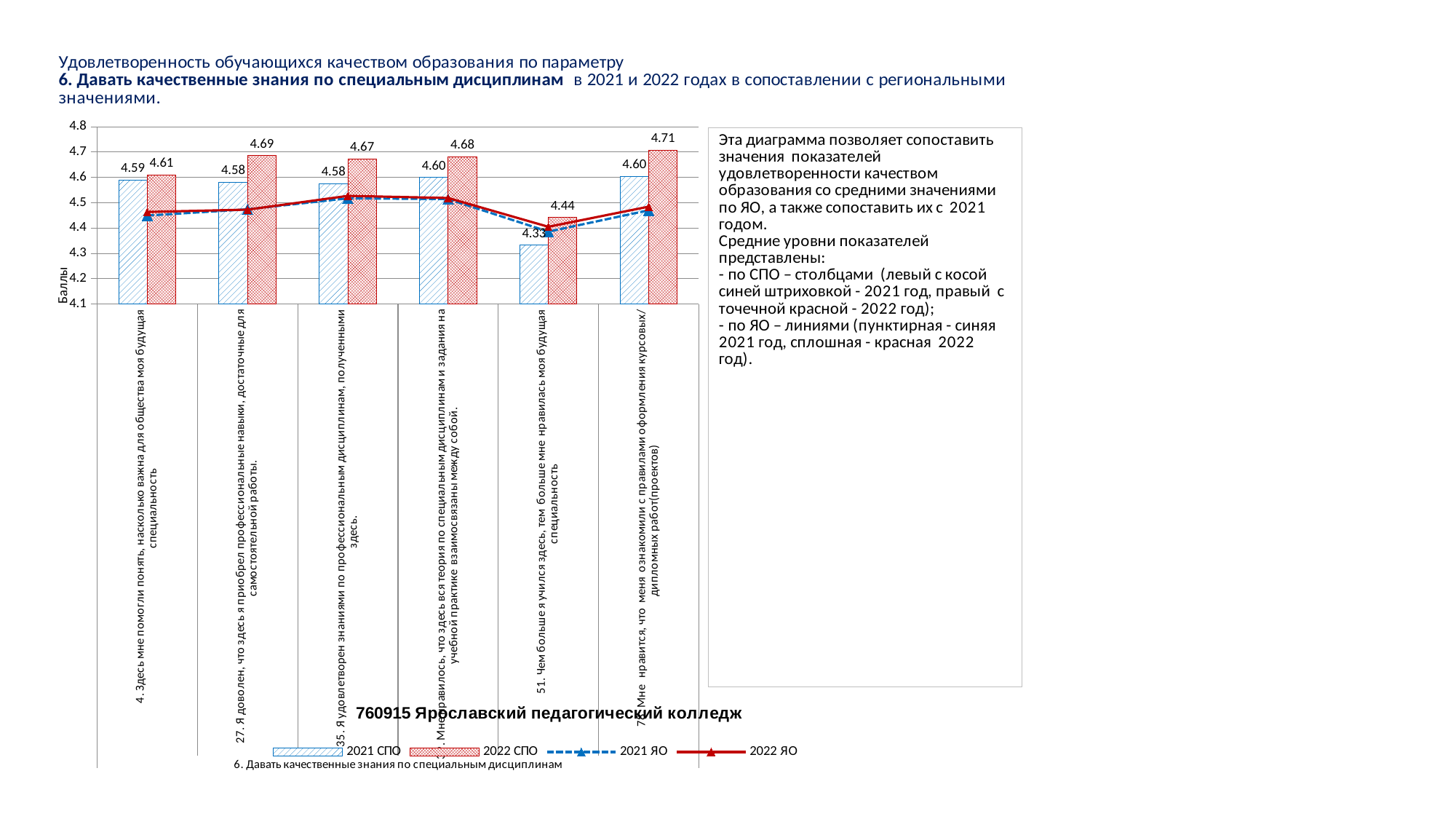
Which category has the lowest 2021 СПО value? 51. Чем больше я учился здесь, тем больше мне нравилась моя будущая специальность How many categories are shown on the x axis? 6 How many series does the legend list? 4 What kind of chart is shown on the slide? Combined bar and line chart What is the 2021 СПО value for category 27 ("Я доволен, что здесь я приобрел профессиональные навыки...")? 4.58 Which category has the highest 2022 СПО value? Мне нравится, что меня ознакомили с правилами оформления курсовых/дипломных работ(проектов) What is the difference between the 2022 СПО and 2021 СПО values for category 27? 0.11 What is the difference between the 2022 СПО and 2021 СПО values for category 51? 0.11 For category 35 ("Я удовлетворен знаниями по профессиональным дисциплинам..."), which is larger: the 2021 СПО value or the 2022 СПО value? 2022 СПО What is the 2022 СПО value for category 4 ("Здесь мне помогли понять, насколько важна для общества моя будущая специальность")? 4.61 What is the 2022 СПО value for category 51 ("Чем больше я учился здесь, тем больше мне нравилась моя будущая специальность")? 4.44